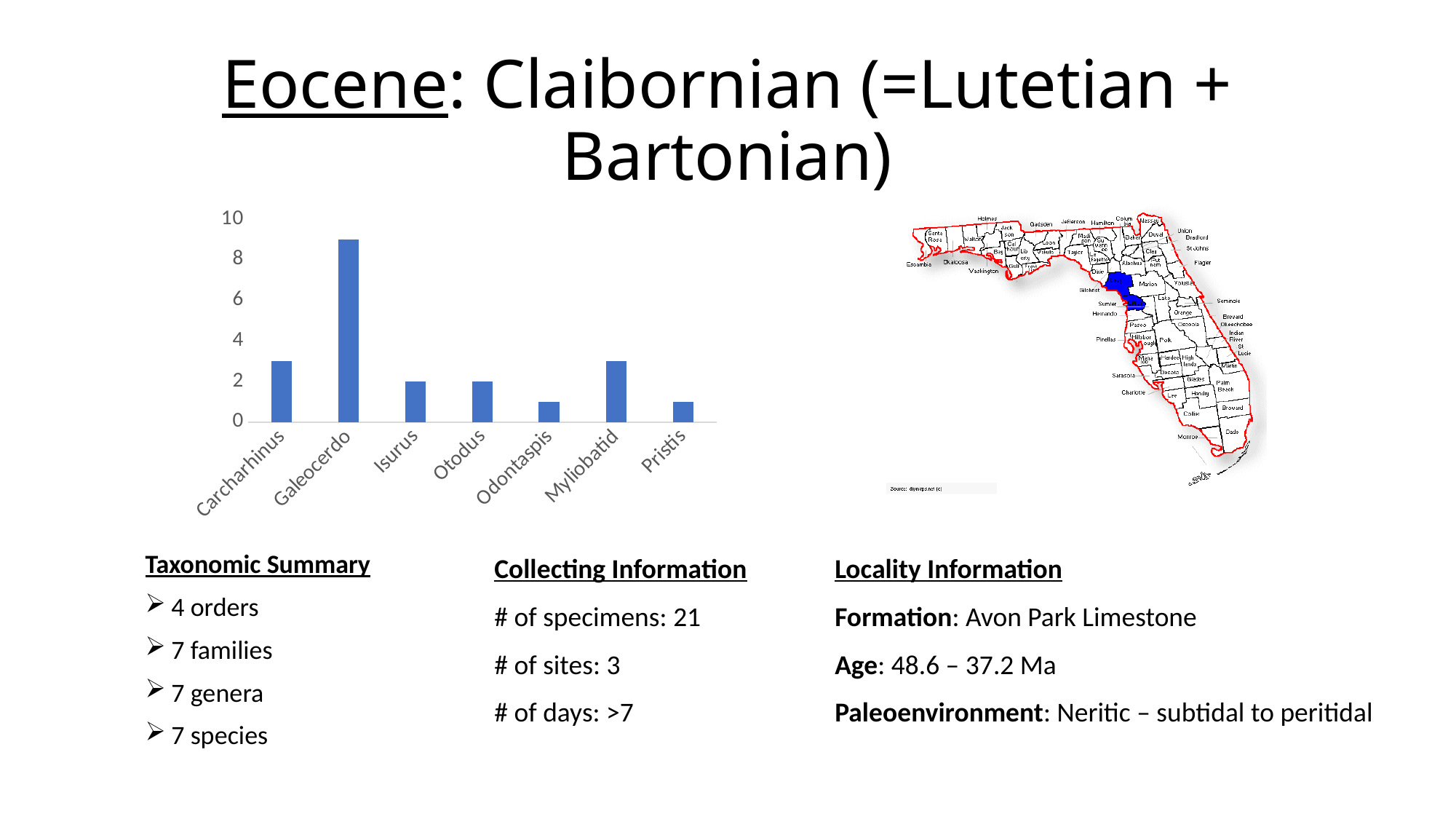
Which is larger, the value for Galeocerdo or the value for Carcharhinus? Galeocerdo Is the value for Myliobatid greater or less than 2? greater What type of chart is shown on the slide? bar chart Is the value for Carcharhinus greater or less than 4? less What is the value for Otodus in the bar chart? 2 What is the highest tick value shown on the vertical axis of the bar chart? 10 Which is larger, the value for Carcharhinus or the value for Pristis? Carcharhinus What is the value for Isurus in the bar chart? 2 Is the value for Odontaspis greater or less than 2? less Which category has the highest bar in the chart? Galeocerdo How many categories are shown on the x axis of the bar chart? 7